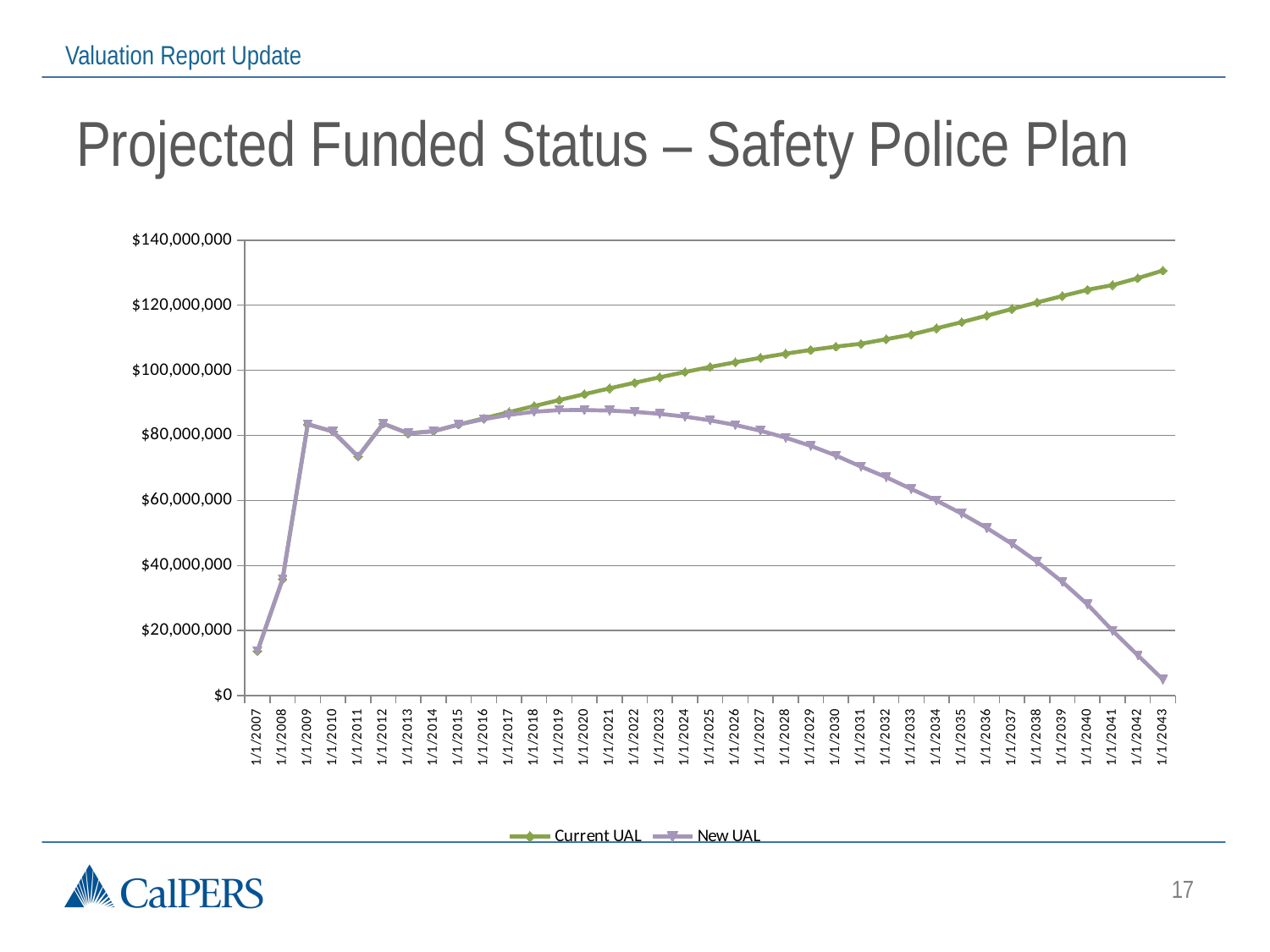
What kind of chart is shown on the slide? Line chart Is the value of Current UAL at 1/1/2043 greater or less than $120,000,000? greater What are the two series named in the legend? Current UAL and New UAL How many series does the legend list? 2 Is the value of Current UAL at 1/1/2030 greater or less than $100,000,000? greater At 1/1/2043, which series has the larger value, Current UAL or New UAL? Current UAL Does the New UAL series rise or fall between 1/1/2025 and 1/1/2043? Fall Is the value of New UAL at 1/1/2043 greater or less than $20,000,000? less What is the title of the chart on the slide? Projected Funded Status – Safety Police Plan How many dates are shown along the x axis? 37 At which date does the Current UAL series reach its highest value? 1/1/2043